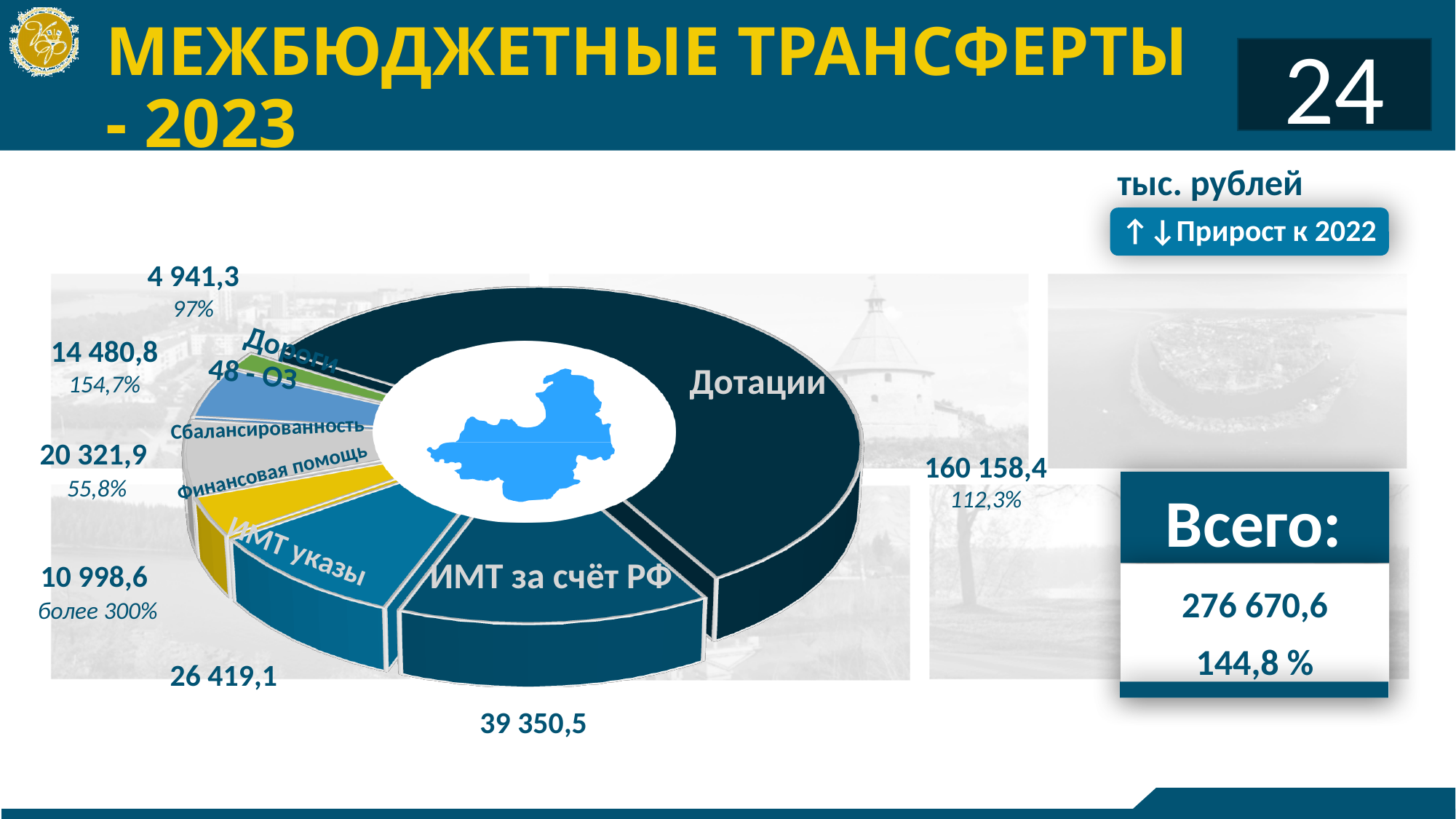
What growth percentage relative to 2022 is shown for 48 - ОЗ? 154,7% What unit of measurement is indicated for the chart values? тыс. рублей How many categories are shown in the pie chart? 7 Which category has the largest slice of the pie? Дотации What is the value for Дотации? 160 158,4 Which is larger, ИМТ указы or Сбалансированность? ИМТ указы What is the value for ИМТ за счёт РФ? 39 350,5 What is the difference between the values for Дотации and ИМТ за счёт РФ? 120 807,9 What kind of chart is shown on the slide? Pie chart Which category has the smallest slice of the pie? Дороги What is the total (Всего) of all categories shown? 276 670,6 What is the value for Сбалансированность? 20 321,9